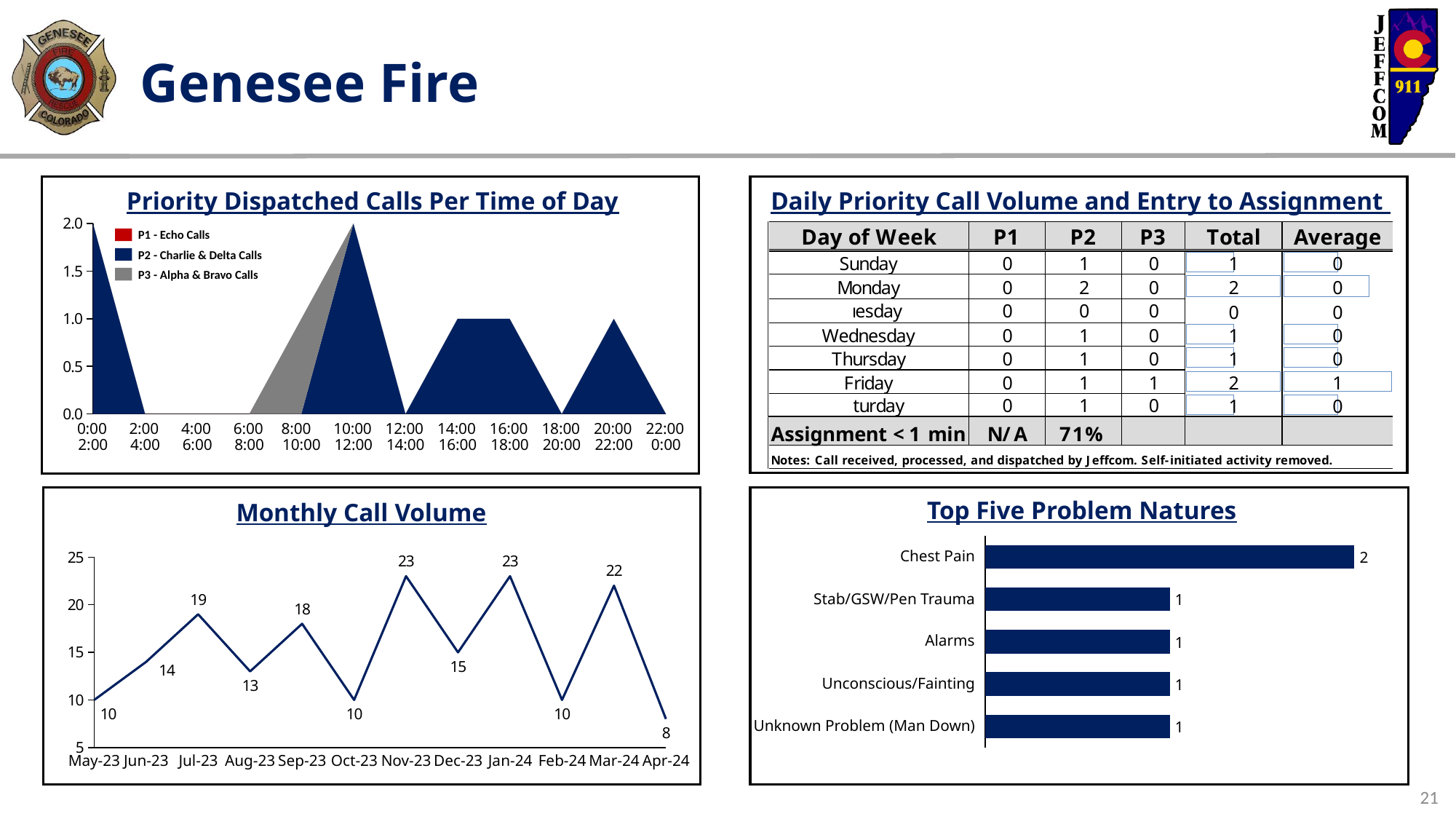
In the Top Five Problem Natures chart, which category has the highest value? Chest Pain In the Monthly Call Volume chart, what is the value for Apr-24? 8 In the Monthly Call Volume chart, which month has the lowest value? Apr-24 In the Monthly Call Volume chart, which is larger, the value for Jul-23 or the value for Sep-23? Jul-23 What kind of chart is the Top Five Problem Natures chart? bar chart In the Monthly Call Volume chart, what is the difference between the values for Mar-24 and Apr-24? 14 How many months are plotted in the Monthly Call Volume chart? 12 In the Top Five Problem Natures chart, what is the value for Chest Pain? 2 In the Monthly Call Volume chart, what is the value for Nov-23? 23 How many series does the legend of the Priority Dispatched Calls Per Time of Day chart list? 3 What kind of chart is the Monthly Call Volume chart? line chart How many categories are shown in the Top Five Problem Natures chart? 5